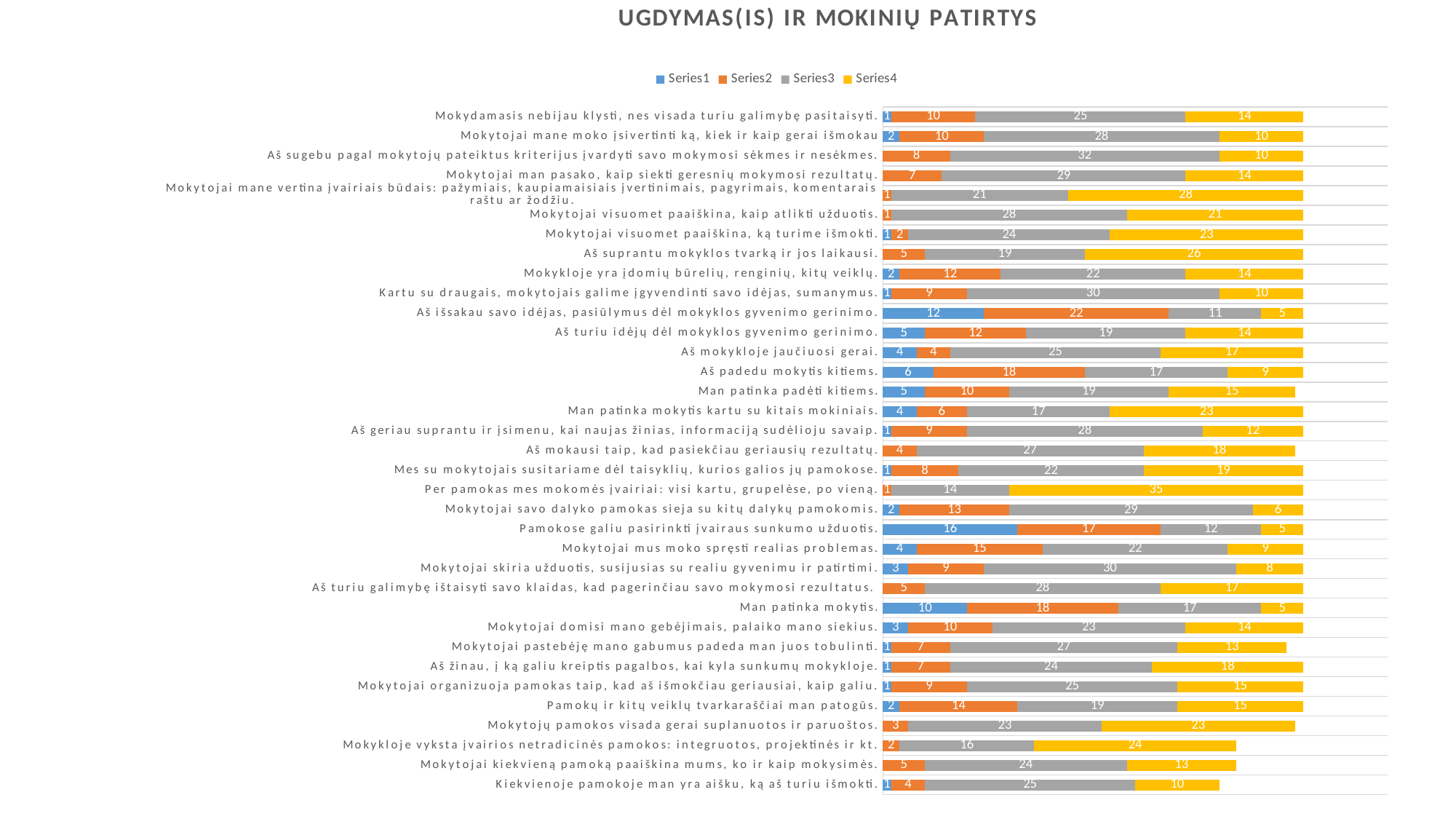
What is the Series2 value for "Aš išsakau savo idėjas, pasiūlymus dėl mokyklos gyvenimo gerinimo."? 22 What is the Series4 value for "Per pamokas mes mokomės įvairiai: visi kartu, grupelėse, po vieną."? 35 What is the total of the stacked bar for "Man patinka mokytis."? 50 Which category has the highest Series4 value? Per pamokas mes mokomės įvairiai: visi kartu, grupelėse, po vieną. What is the difference between the Series3 values for "Kartu su draugais, mokytojais galime įgyvendinti savo idėjas, sumanymus." and "Aš išsakau savo idėjas, pasiūlymus dėl mokyklos gyvenimo gerinimo."? 19 What is the Series1 value for "Pamokose galiu pasirinkti įvairaus sunkumo užduotis."? 16 Which category has the highest Series1 value? Pamokose galiu pasirinkti įvairaus sunkumo užduotis. How many series does the legend list? 4 What kind of chart is shown on the slide? stacked bar chart Which is larger: the Series2 value for "Aš padedu mokytis kitiems." or the Series2 value for "Man patinka padėti kitiems."? Aš padedu mokytis kitiems. What is the total of the stacked bar for "Kiekvienoje pamokoje man yra aišku, ką aš turiu išmokti."? 40 What is the Series3 value for "Aš sugebu pagal mokytojų pateiktus kriterijus įvardyti savo mokymosi sėkmes ir nesėkmes."? 32